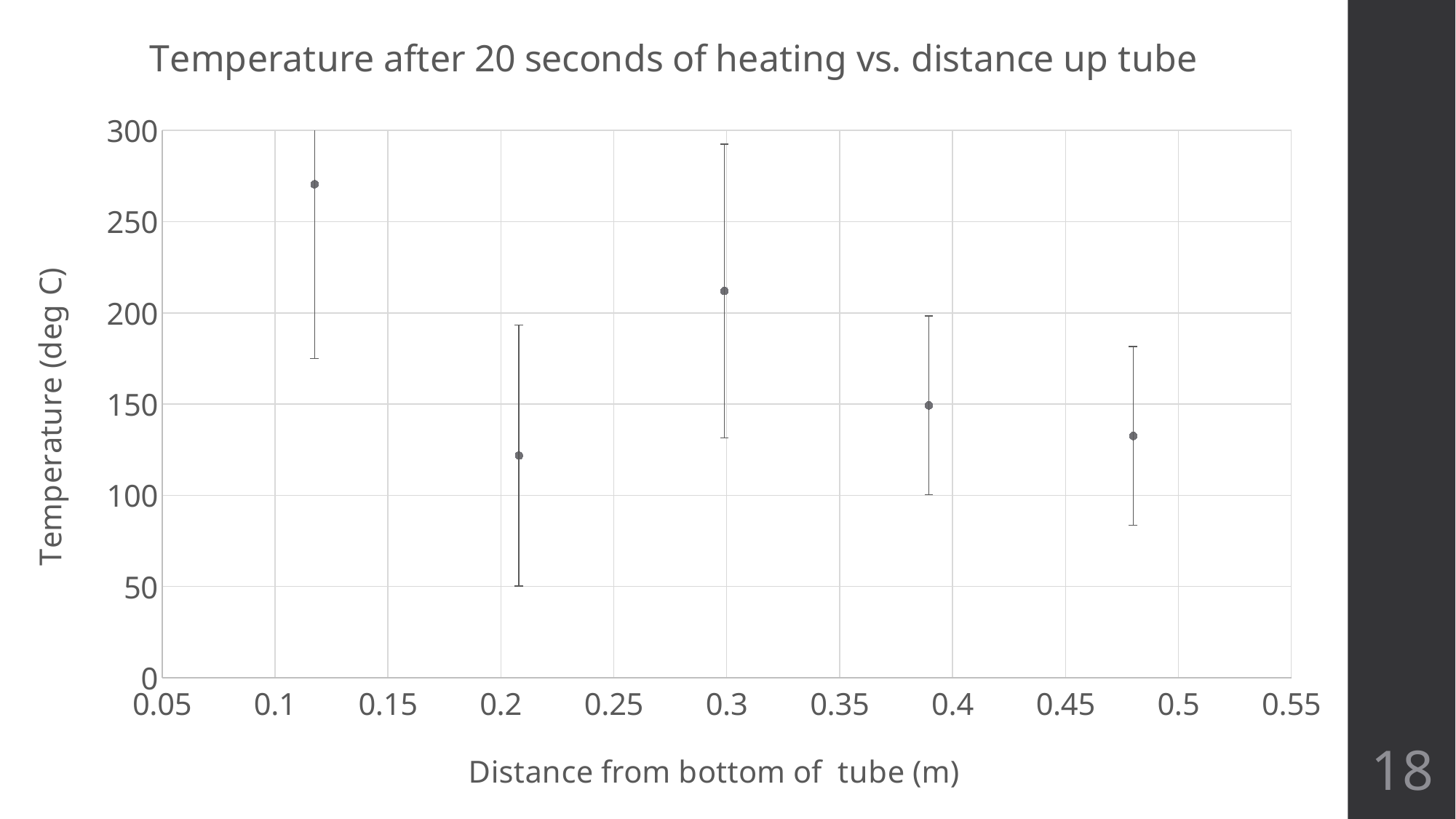
Is the temperature for the point near 0.3 m greater or less than 200? greater Is the temperature for the point near 0.21 m greater or less than 150? less Is the temperature for the point near 0.39 m greater or less than 100? greater What is the label of the vertical axis? Temperature (deg C) What is the title of the chart? Temperature after 20 seconds of heating vs. distance up tube Overall, does the temperature rise or fall as the distance from the bottom of the tube increases? fall Which has the higher temperature, the point near 0.3 m or the point near 0.39 m? the point near 0.3 m What kind of chart is shown on the slide? scatter chart How many data points are plotted on the chart? 5